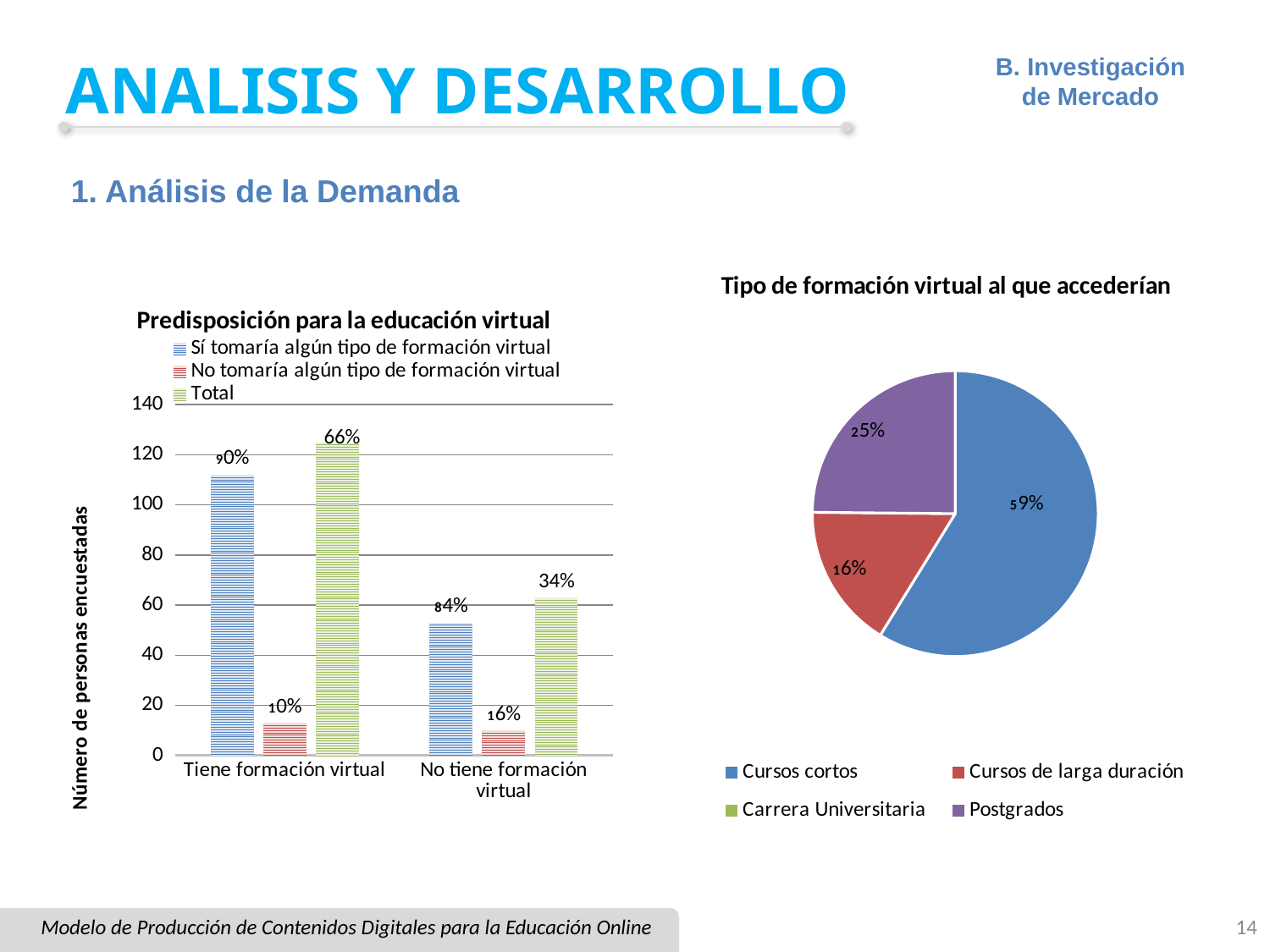
In the chart "Predisposición para la educación virtual", is the "Sí tomaría algún tipo de formación virtual" bar for "Tiene formación virtual" greater or less than 100? greater In the pie chart "Tipo de formación virtual al que accederían", which category has the largest slice? Cursos cortos In the pie chart "Tipo de formación virtual al que accederían", how many percentage points larger is the Cursos cortos slice than the Cursos de larga duración slice? 43 What kind of chart is "Predisposición para la educación virtual"? bar chart In the pie chart "Tipo de formación virtual al que accederían", what share is labelled for Postgrados? 25% In the chart "Predisposición para la educación virtual", what data label is shown on the Total bar for "Tiene formación virtual"? 66% In the chart "Predisposición para la educación virtual", how many categories are shown on the x axis? 2 In the chart "Tipo de formación virtual al que accederían", how many entries does the legend list? 4 In the chart "Predisposición para la educación virtual", what data label is shown on the "No tomaría algún tipo de formación virtual" bar for "No tiene formación virtual"? 16% In the pie chart "Tipo de formación virtual al que accederían", what share is labelled for Cursos cortos? 59% In the chart "Predisposición para la educación virtual", how many series does the legend list? 3 What kind of chart is "Tipo de formación virtual al que accederían"? pie chart